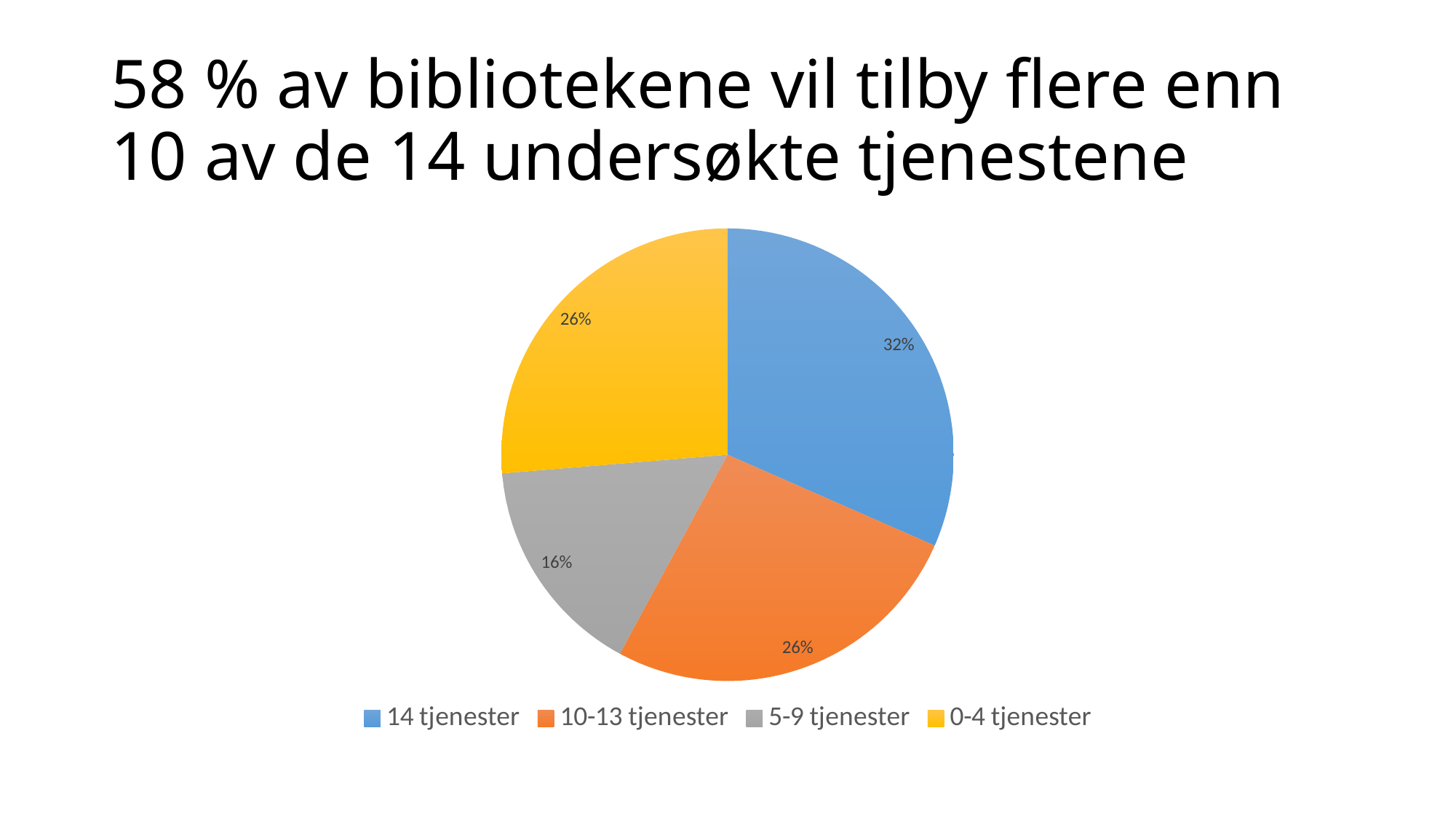
What kind of chart is shown on the slide? pie chart Which is larger, the "14 tjenester" slice or the "0-4 tjenester" slice? 14 tjenester Which category has the largest slice of the pie? 14 tjenester What colour is the "5-9 tjenester" slice? grey What is the difference in percentage points between the "14 tjenester" slice and the "5-9 tjenester" slice? 16 What share of the pie does the "14 tjenester" slice represent? 32% What share of the pie does the "10-13 tjenester" slice represent? 26% How many entries does the legend list? 4 What share of the pie does the "5-9 tjenester" slice represent? 16% How many slices does the pie chart have? 4 What share of the pie does the "0-4 tjenester" slice represent? 26% Which category has the smallest slice of the pie? 5-9 tjenester